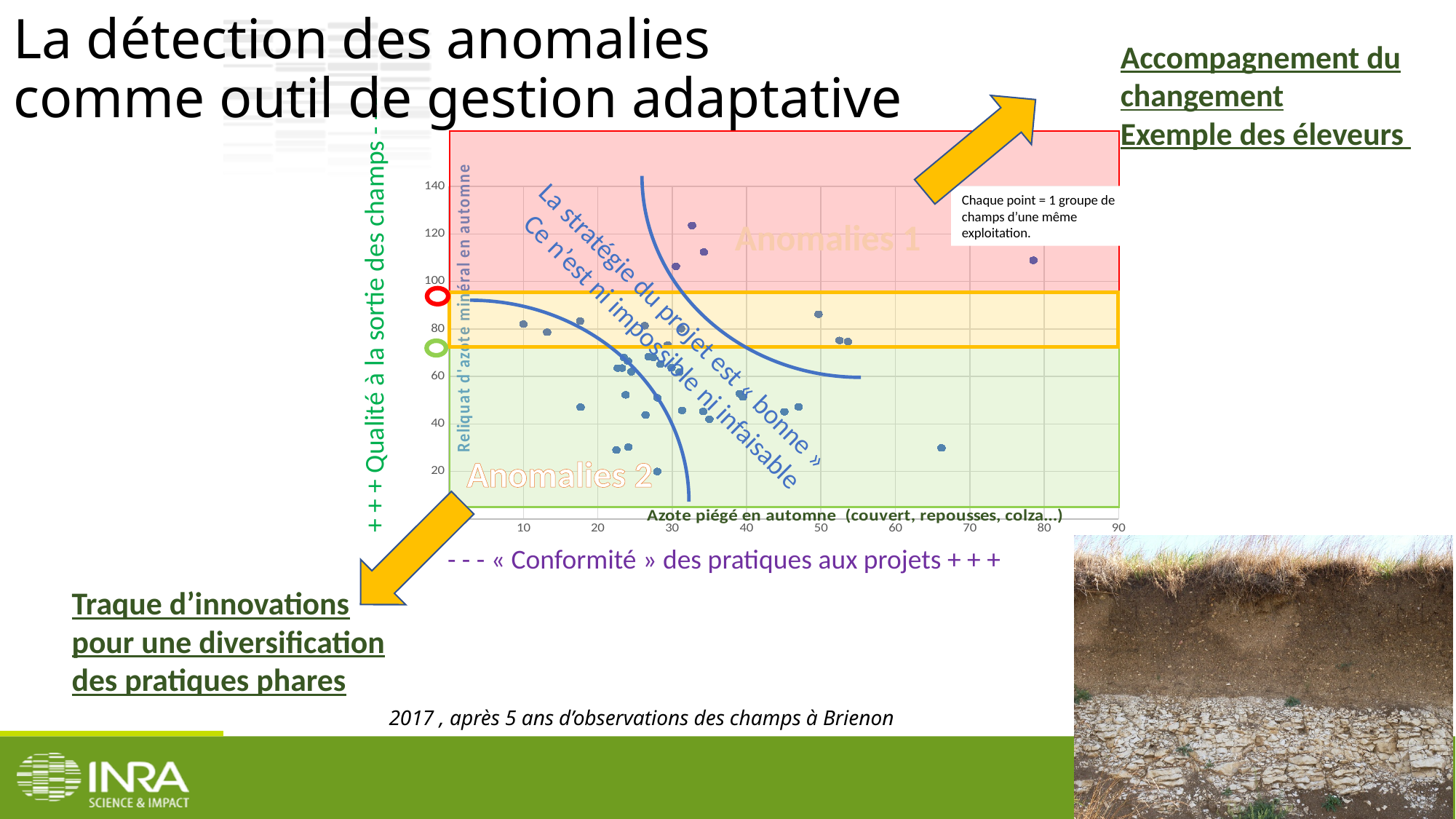
Which has the higher vertical-axis value: the point near 78 on the horizontal axis or the point near 66? the point near 78 How many points lie above 100 on the vertical axis? 4 How many points have a horizontal-axis value greater than 60? 2 Is the vertical-axis value of the leftmost point (near 10 on the horizontal axis) greater or less than 60? greater What kind of chart is shown on the slide? scatter chart What is the title of the vertical axis of the chart? Reliquat d'azote minéral en automne Is the vertical-axis value of the rightmost point (near 78 on the horizontal axis) greater or less than 100? greater Is the vertical-axis value of the highest point on the chart greater or less than 100? greater What is the title of the horizontal axis of the chart? Azote piégé en automne (couvert, repousses, colza...)